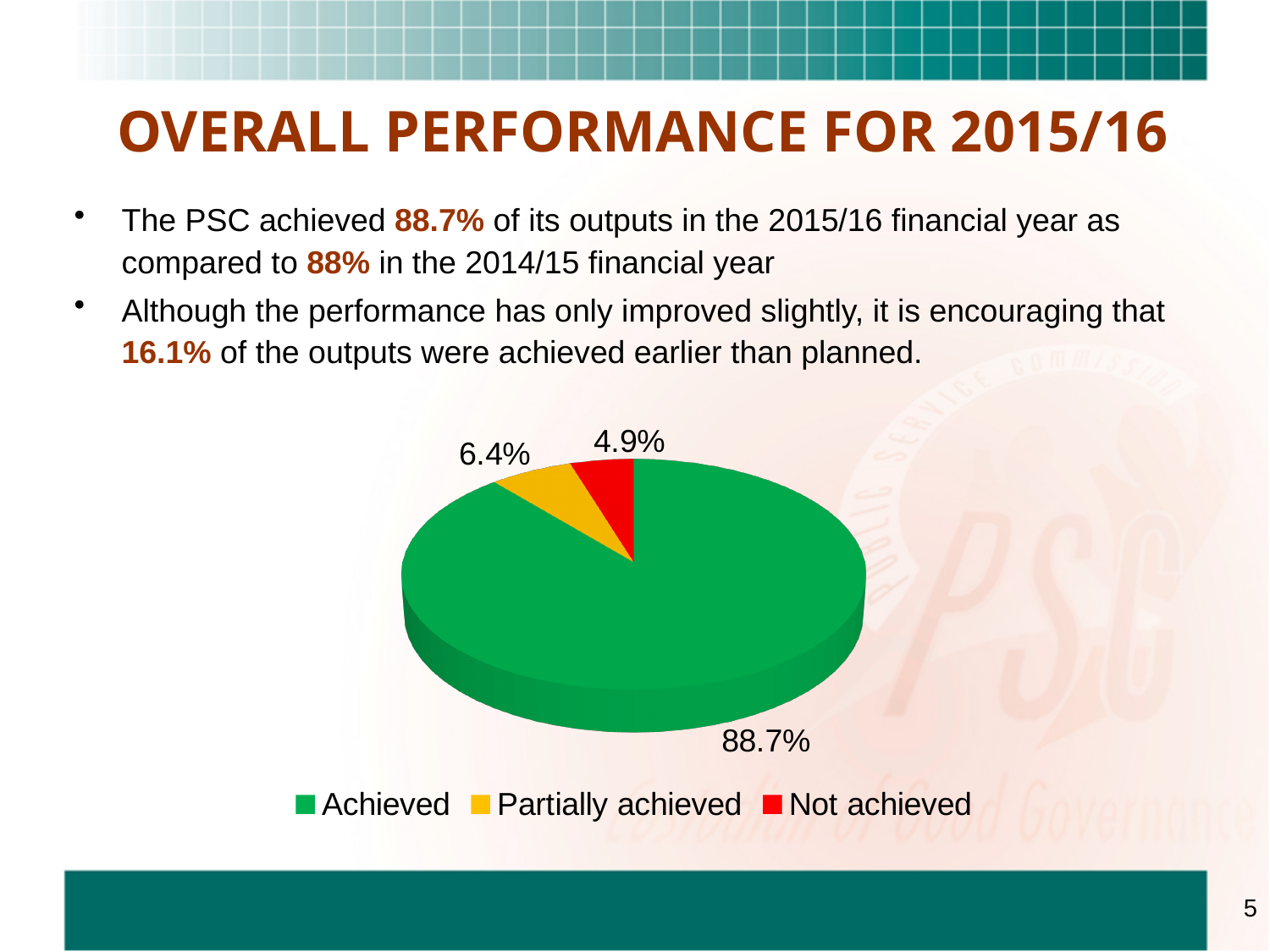
What percentage of outputs were partially achieved? 6.4% How many categories does the pie chart show? 3 What colour represents the Not achieved category in the pie chart? Red What is the difference in percentage points between Partially achieved and Not achieved? 1.5 Which category has the smallest share of the pie? Not achieved What percentage of outputs were not achieved? 4.9% What percentage of outputs were achieved according to the pie chart? 88.7% What is the difference in percentage points between Achieved and Partially achieved? 82.3 What kind of chart is shown on the slide? Pie chart Which is larger, the Partially achieved share or the Not achieved share? Partially achieved Which category has the largest share of the pie? Achieved What colour represents the Achieved category in the pie chart? Green